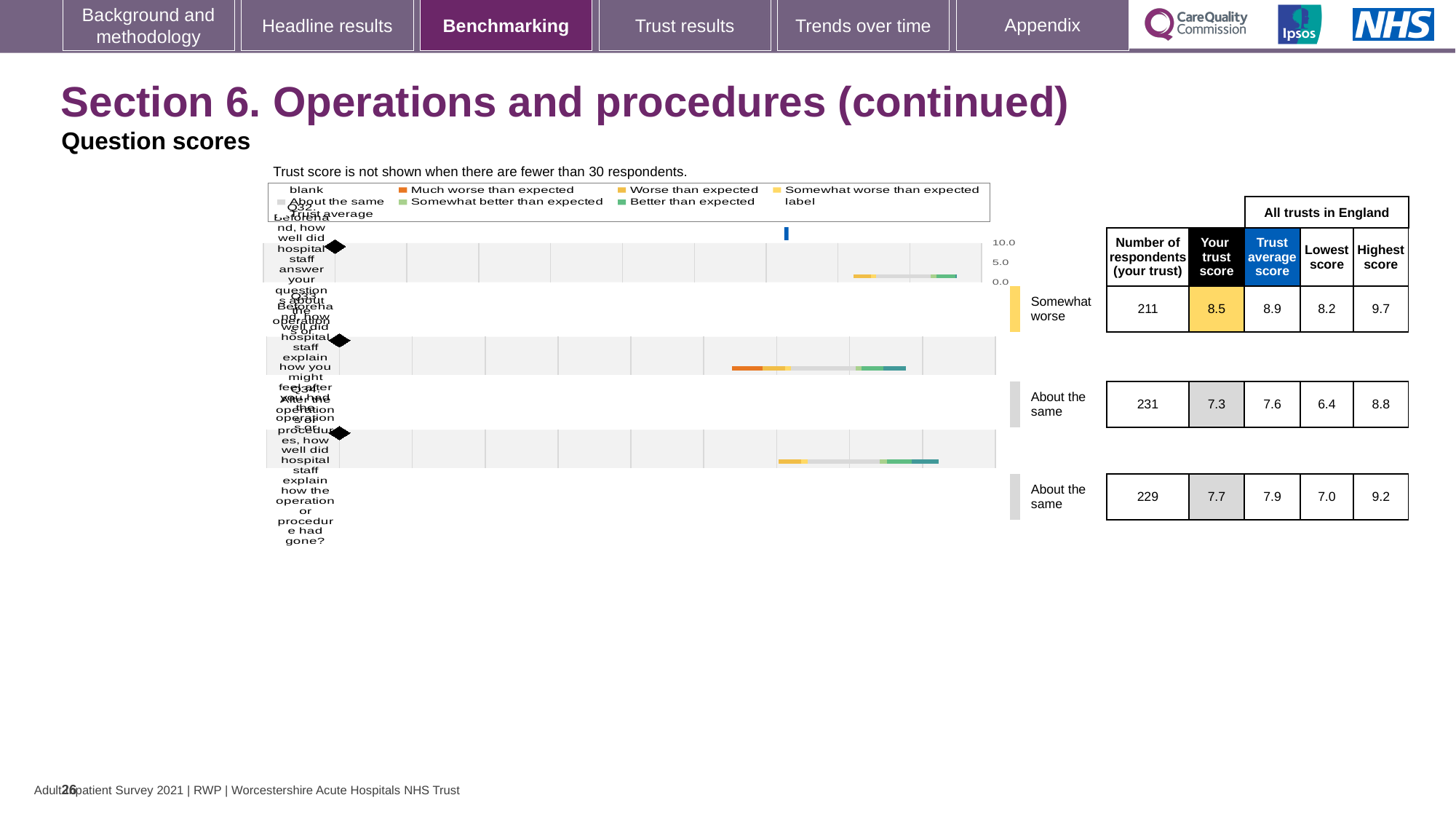
How many question rows are shown in the benchmarking chart and table? 3 Which row of the table has the highest 'Your trust score'? The first row (211 respondents), 8.5 What kind of chart is used to show the benchmarking results? Bar chart In the table, what is the 'Highest score' for the row with 211 respondents? 9.7 In the table, what is the 'Your trust score' for the row with 211 respondents? 8.5 Which row of the table has the lowest 'Lowest score'? The second row (231 respondents), 6.4 What benchmark category label is shown for the row with 211 respondents? Somewhat worse In the table, what is the 'Lowest score' for the row with 231 respondents? 6.4 In the table, what is the 'Trust average score' for the row with 211 respondents? 8.9 For the row with 211 respondents, what is the difference between the 'Trust average score' and the 'Your trust score'? 0.4 For the row with 231 respondents, which is larger: the 'Your trust score' or the 'Trust average score'? Trust average score (7.6) In the table, what is the 'Your trust score' for the row with 229 respondents? 7.7